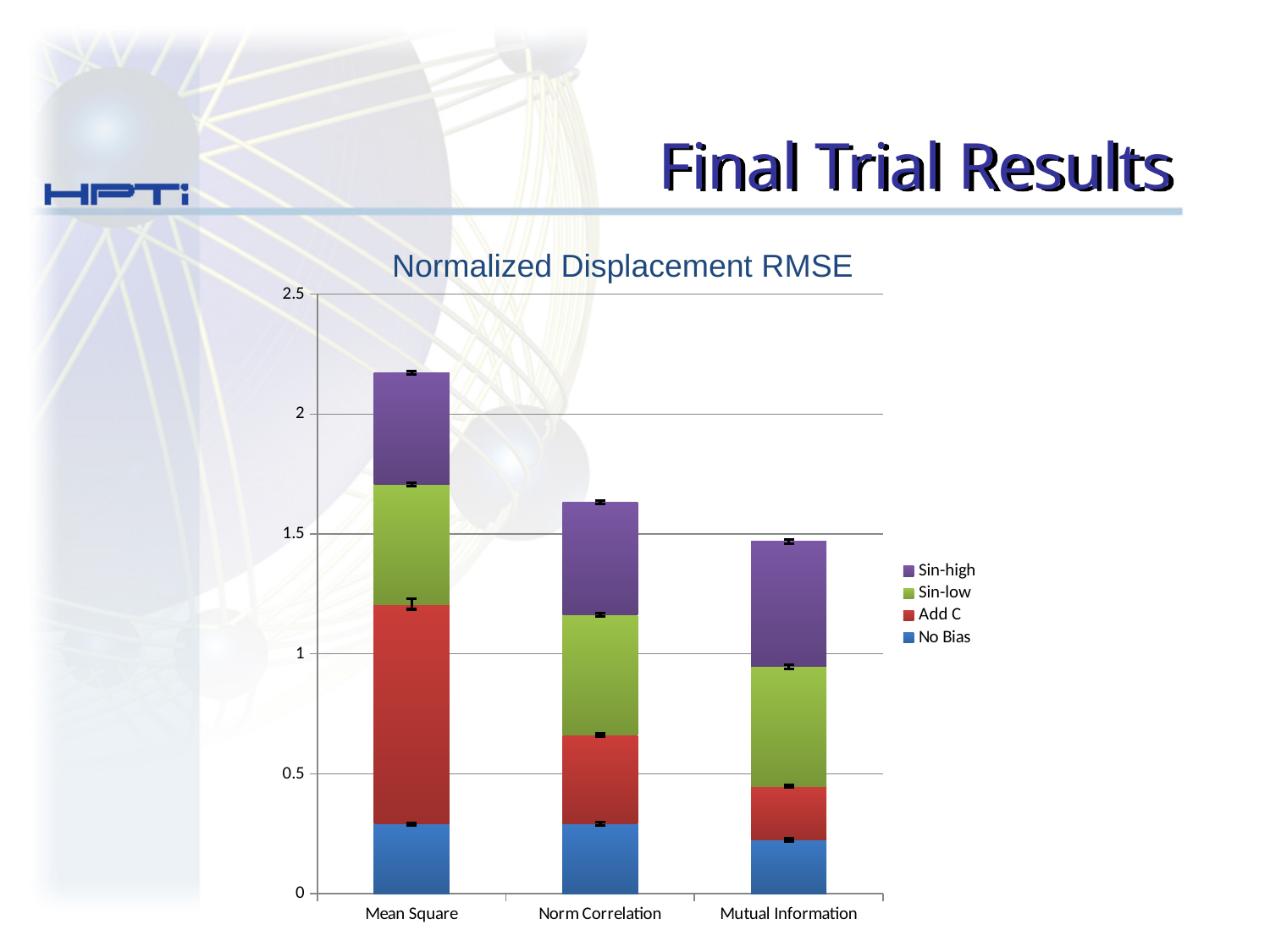
Is the total stacked value for Norm Correlation greater or less than 1.5? greater What kind of chart is shown on the slide? Stacked bar chart How many series does the legend list? 4 Which series is shown in purple at the top of each stacked bar? Sin-high Which category has the larger Add C segment, Mean Square or Norm Correlation? Mean Square Do the total stacked values rise or fall from Mean Square to Mutual Information along the x axis? fall Which category has the lowest total stacked bar? Mutual Information Which category has the highest total stacked bar? Mean Square How many categories are shown on the x axis of the chart? 3 Is the total stacked value for Mutual Information greater or less than 1? greater Is the total stacked value for Mean Square greater or less than 2? greater What is the title of the chart? Normalized Displacement RMSE